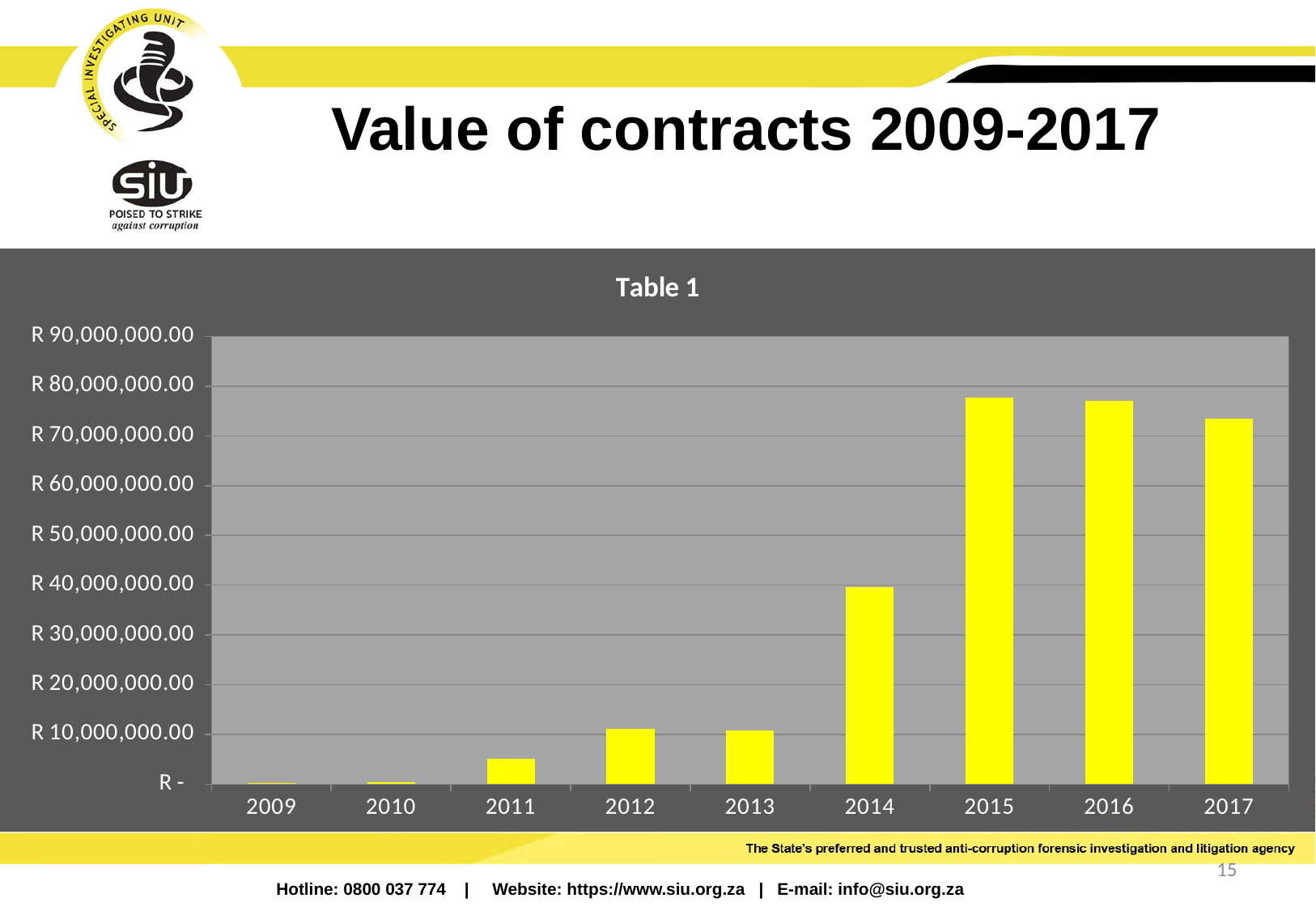
Is the value for 2014 greater or less than R 30,000,000.00? greater Is the value for 2015 greater or less than R 70,000,000.00? greater Do the values generally rise or fall from 2009 to 2015? rise How many years are shown on the x axis of the chart? 9 Is the value for 2017 greater or less than R 80,000,000.00? less What kind of chart is shown on the slide? bar chart What is the title shown above the chart? Table 1 Which year has the larger value, 2014 or 2015? 2015 Which year has the larger value, 2011 or 2012? 2012